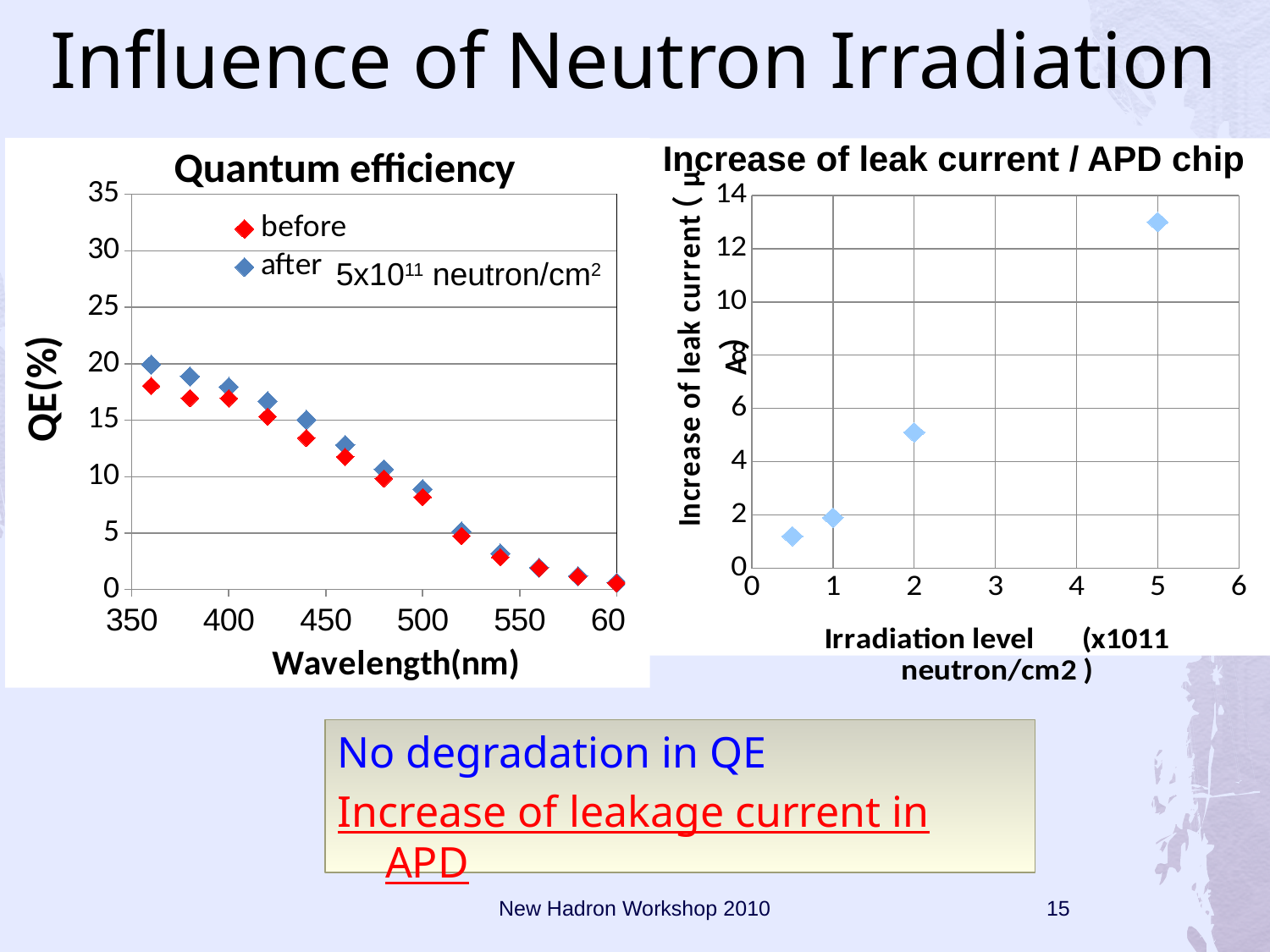
In the 'Increase of leak current / APD chip' chart, does the leak current increase rise or fall as irradiation level increases? rise In the Quantum efficiency chart, is the 'before' value at 500 nm greater or less than 10? less In the Quantum efficiency chart, at 440 nm, which series has the larger value, 'before' or 'after'? after What are the two legend entries in the Quantum efficiency chart? before, after In the Quantum efficiency chart, is the 'before' value at 360 nm greater or less than 15? greater In the 'Increase of leak current / APD chip' chart, is the value at irradiation level 5 greater or less than 12? greater What kind of chart is the Quantum efficiency chart? scatter chart In the Quantum efficiency chart, do the QE values rise or fall as wavelength increases? fall How many data points are plotted in the 'Increase of leak current / APD chip' chart? 4 In the 'Increase of leak current / APD chip' chart, which irradiation level has the highest increase of leak current? 5 How many series does the legend of the Quantum efficiency chart list? 2